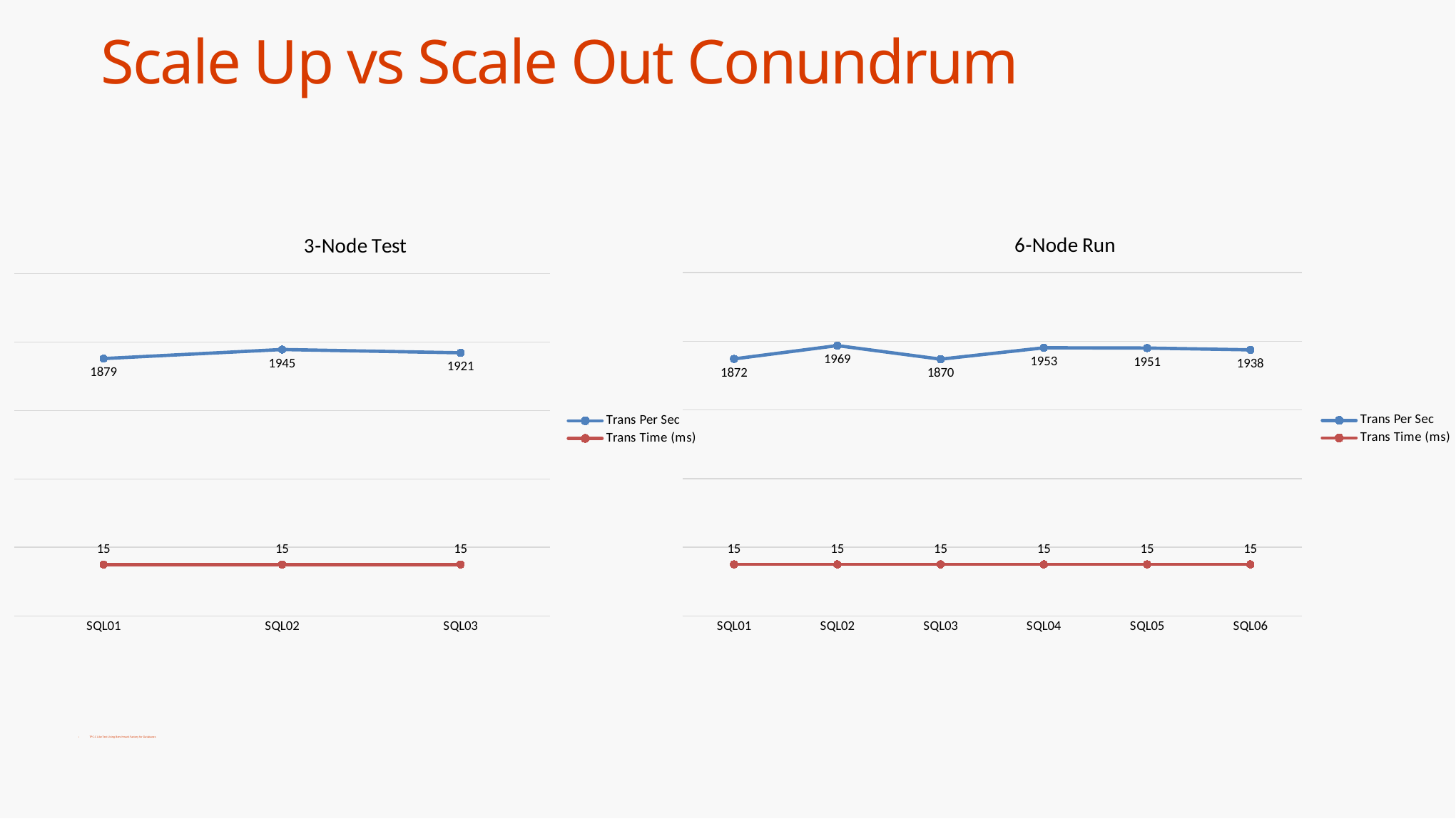
How many nodes are plotted on the x axis of the 6-Node Run chart? 6 In the 3-Node Test chart, which node has the lowest Trans Per Sec? SQL01 In the 6-Node Run chart, what is the difference in Trans Per Sec between SQL02 and SQL03? 99 In the 6-Node Run chart, which has a higher Trans Per Sec, SQL04 or SQL06? SQL04 In the 3-Node Test chart, what is the Trans Per Sec value for SQL02? 1945 What kind of chart is the 3-Node Test chart? Line chart In the 3-Node Test chart, what is the difference in Trans Per Sec between SQL02 and SQL01? 66 In the 6-Node Run chart, what is the Trans Time (ms) value for SQL05? 15 In the 3-Node Test chart, does the Trans Time (ms) series rise, fall, or stay flat across the nodes? Stays flat In the 6-Node Run chart, which node has the highest Trans Per Sec? SQL02 How many series does the legend of the 3-Node Test chart list? 2 In the 6-Node Run chart, what is the Trans Per Sec value for SQL03? 1870